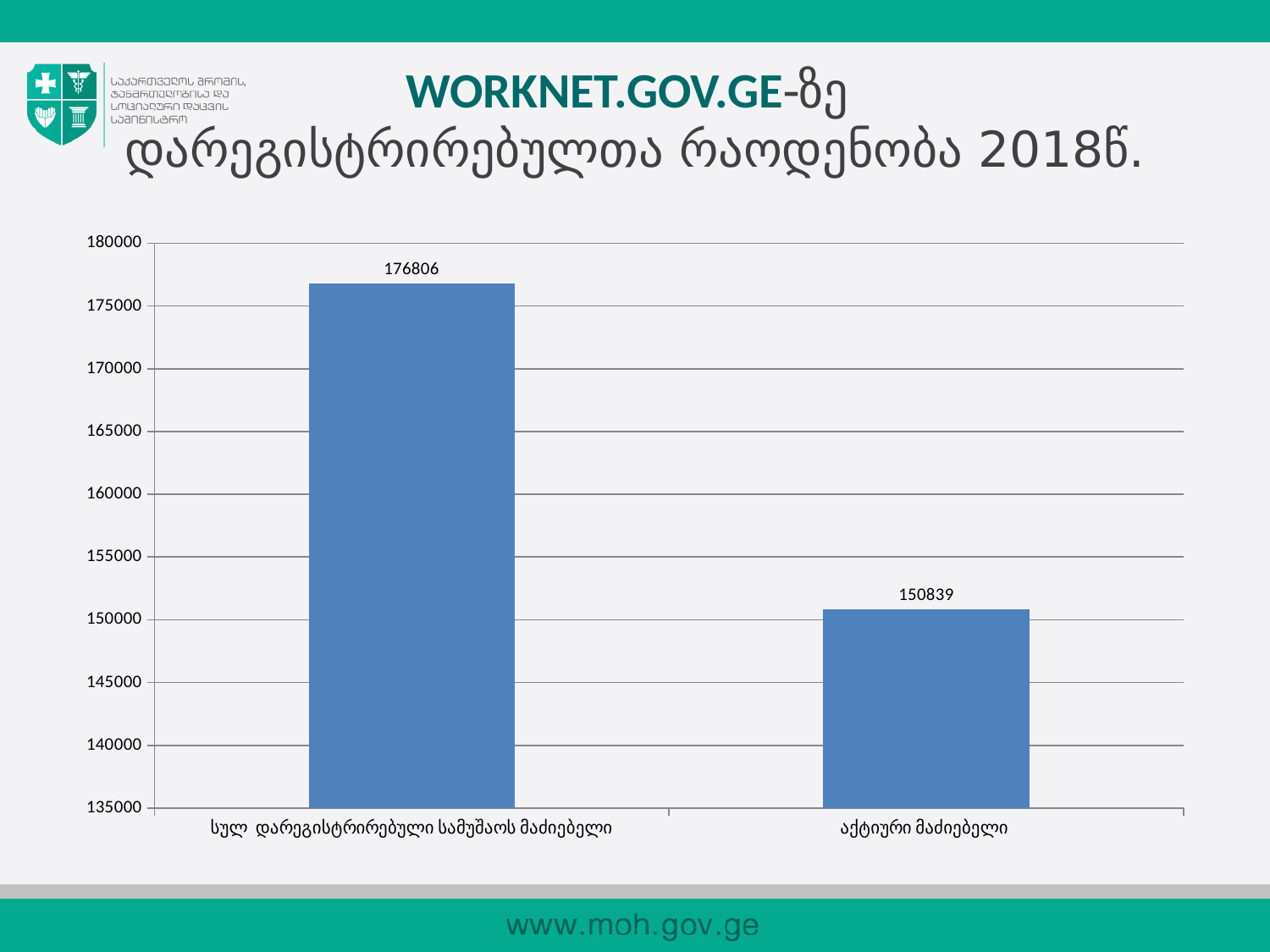
Do the values rise or fall from left to right along the x axis? fall What is the value for აქტიური მაძიებელი? 150839 How many categories are shown on the chart? 2 Is the value for სულ დარეგისტრირებული სამუშაოს მაძიებელი greater or less than 175000? greater What is the lowest value shown on the vertical axis of the chart? 135000 Which category has the highest value? სულ დარეგისტრირებული სამუშაოს მაძიებელი What is the value for სულ დარეგისტრირებული სამუშაოს მაძიებელი? 176806 What is the difference between the value for სულ დარეგისტრირებული სამუშაოს მაძიებელი and the value for აქტიური მაძიებელი? 25967 Which category has the lowest value? აქტიური მაძიებელი Which is larger: the value for აქტიური მაძიებელი or the value for სულ დარეგისტრირებული სამუშაოს მაძიებელი? სულ დარეგისტრირებული სამუშაოს მაძიებელი What kind of chart is shown on the slide? bar chart Is the value for აქტიური მაძიებელი greater or less than 155000? less